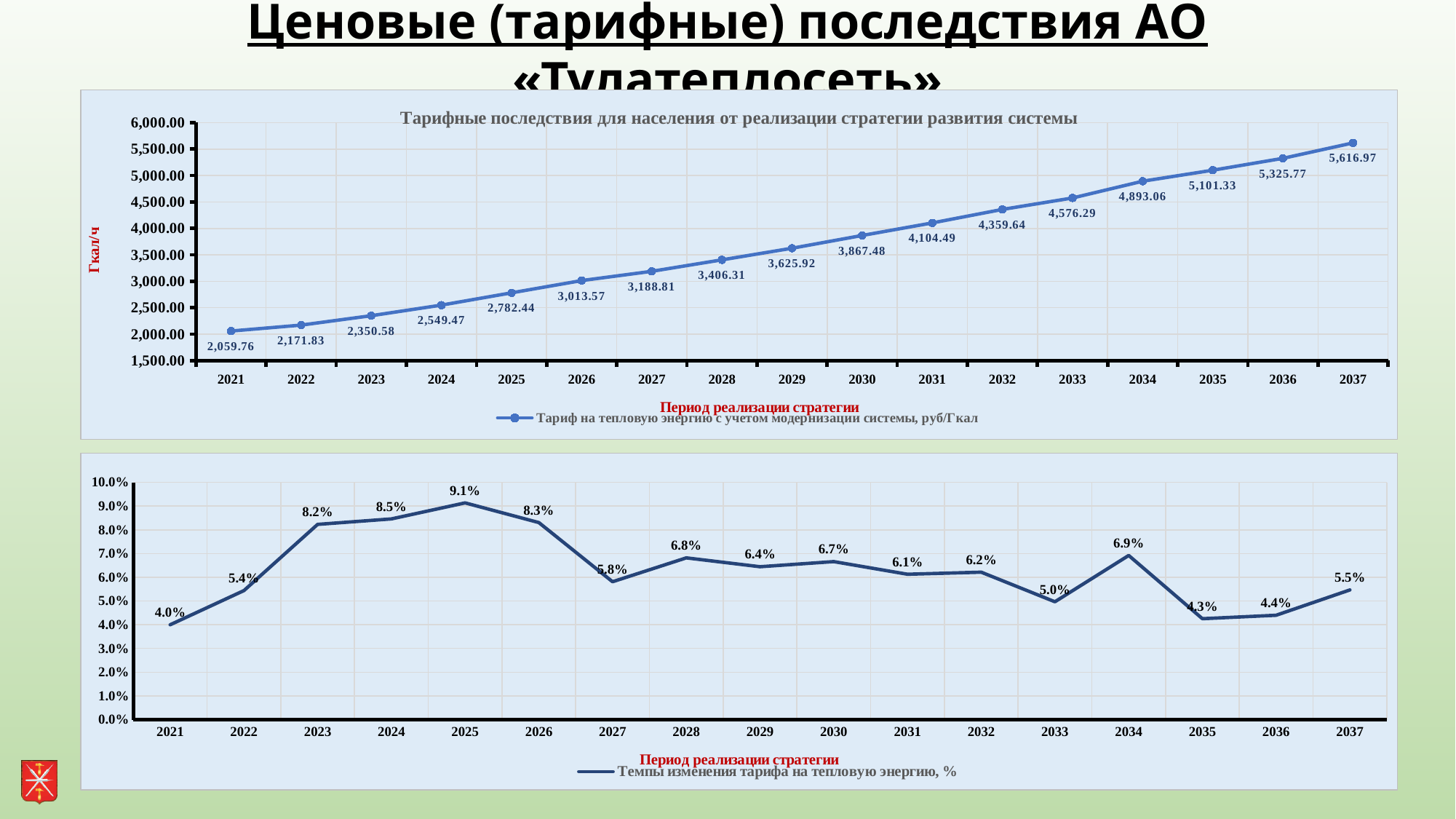
In the top chart, which year has the highest tariff value? 2037 In the top chart, what is the y-axis label? Гкал/ч What kind of chart is the top chart? line chart In the bottom chart, what is the value for 2025? 9.1% In the top chart, what is the difference between the tariff values for 2037 and 2036? 291.20 In the top chart, do the values rise or fall from 2021 to 2037? rise In the top chart, what is the tariff value for 2030? 3,867.48 In the bottom chart, which is larger, the value for 2034 or the value for 2033? 2034 In the bottom chart, what is the difference between the values for 2025 and 2021? 5.1% In the top chart, what is the tariff value for 2021? 2,059.76 In the top chart, how many years are plotted on the x axis? 17 In the bottom chart, which year has the lowest value? 2021